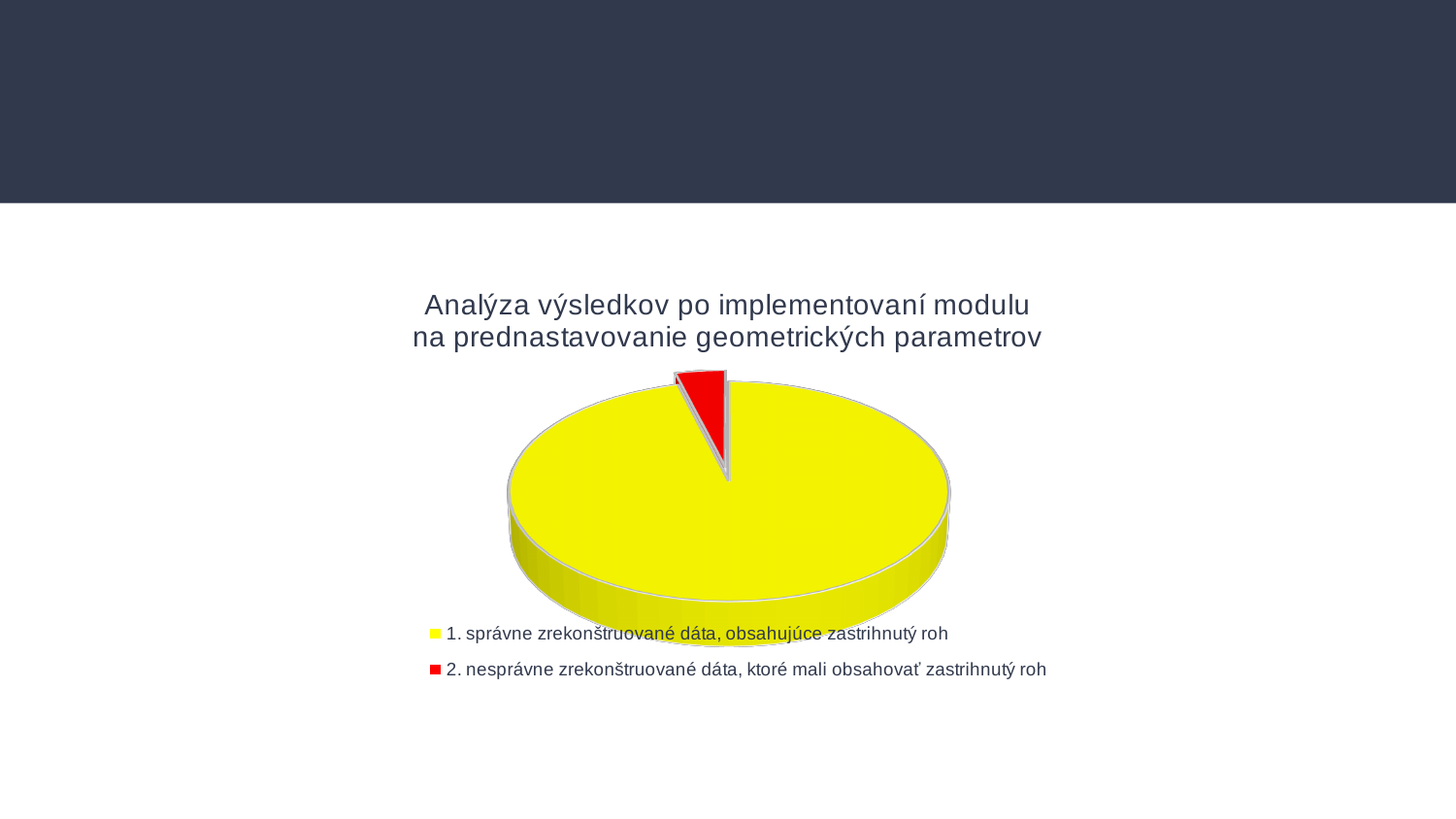
Which category has the smallest slice of the pie? 2. nesprávne zrekonštruované dáta, ktoré mali obsahovať zastrihnutý roh Which category has the largest slice of the pie? 1. správne zrekonštruované dáta, obsahujúce zastrihnutý roh What is the title of the chart? Analýza výsledkov po implementovaní modulu na prednastavovanie geometrických parametrov How many entries does the legend list? 2 What kind of chart is shown on the slide? Pie chart How many slices does the pie chart have? 2 Which slice is larger: the one for correctly reconstructed data (1.) or the one for incorrectly reconstructed data (2.)? 1. správne zrekonštruované dáta, obsahujúce zastrihnutý roh What colour is the slice for '2. nesprávne zrekonštruované dáta, ktoré mali obsahovať zastrihnutý roh'? Red